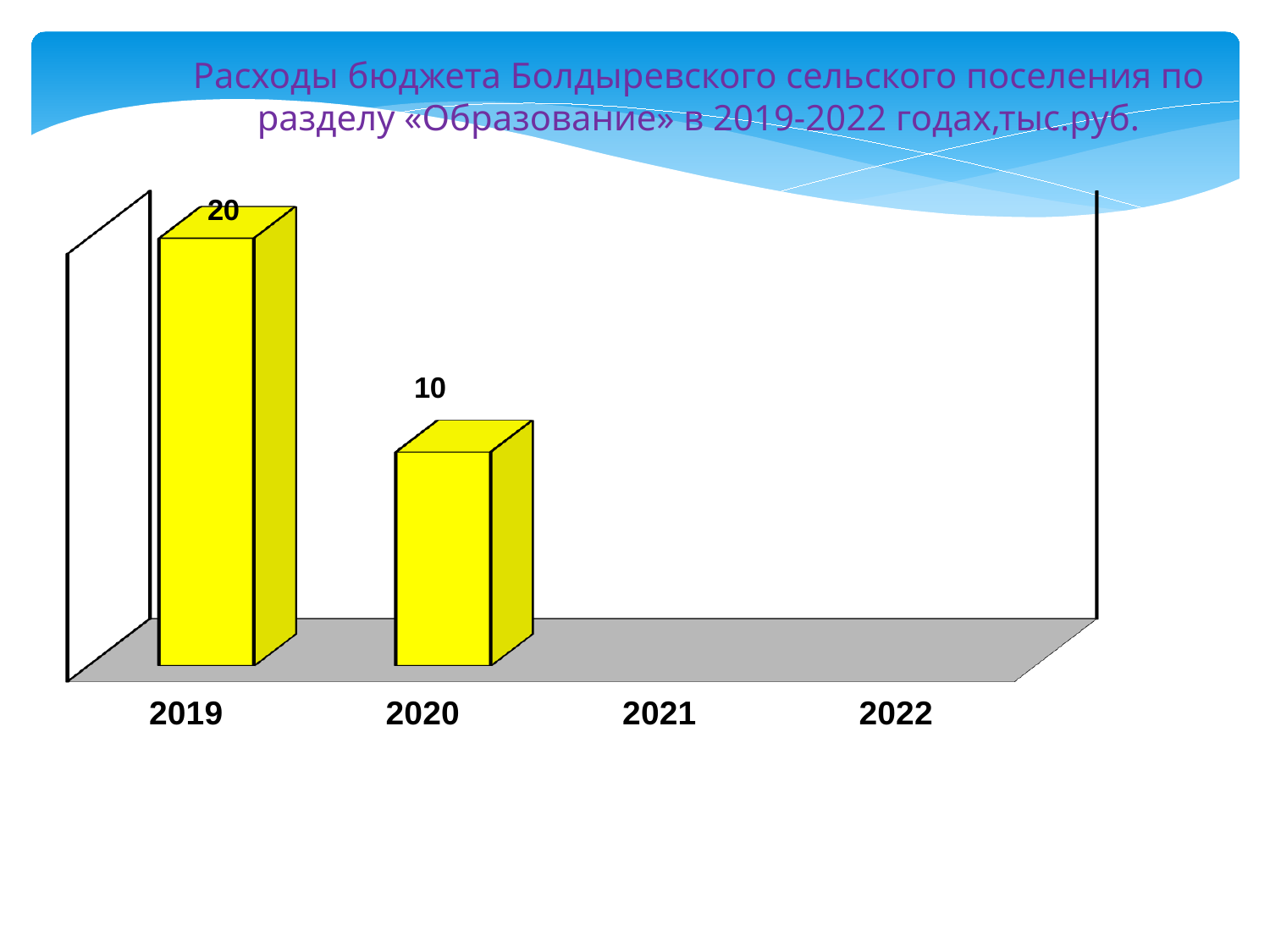
What colour are the bars in the chart? Yellow Do the values rise or fall from 2019 to 2020? Fall Which is larger, the value for 2019 or the value for 2020? 2019 How many years are listed on the x axis? 4 What is the value for 2019? 20 How many bars are plotted on the chart? 2 What is the difference between the values for 2019 and 2020? 10 What is the value for 2020? 10 What unit of measurement is stated in the chart title? тыс.руб. What kind of chart is shown on the slide? Bar chart Which year has the highest value? 2019